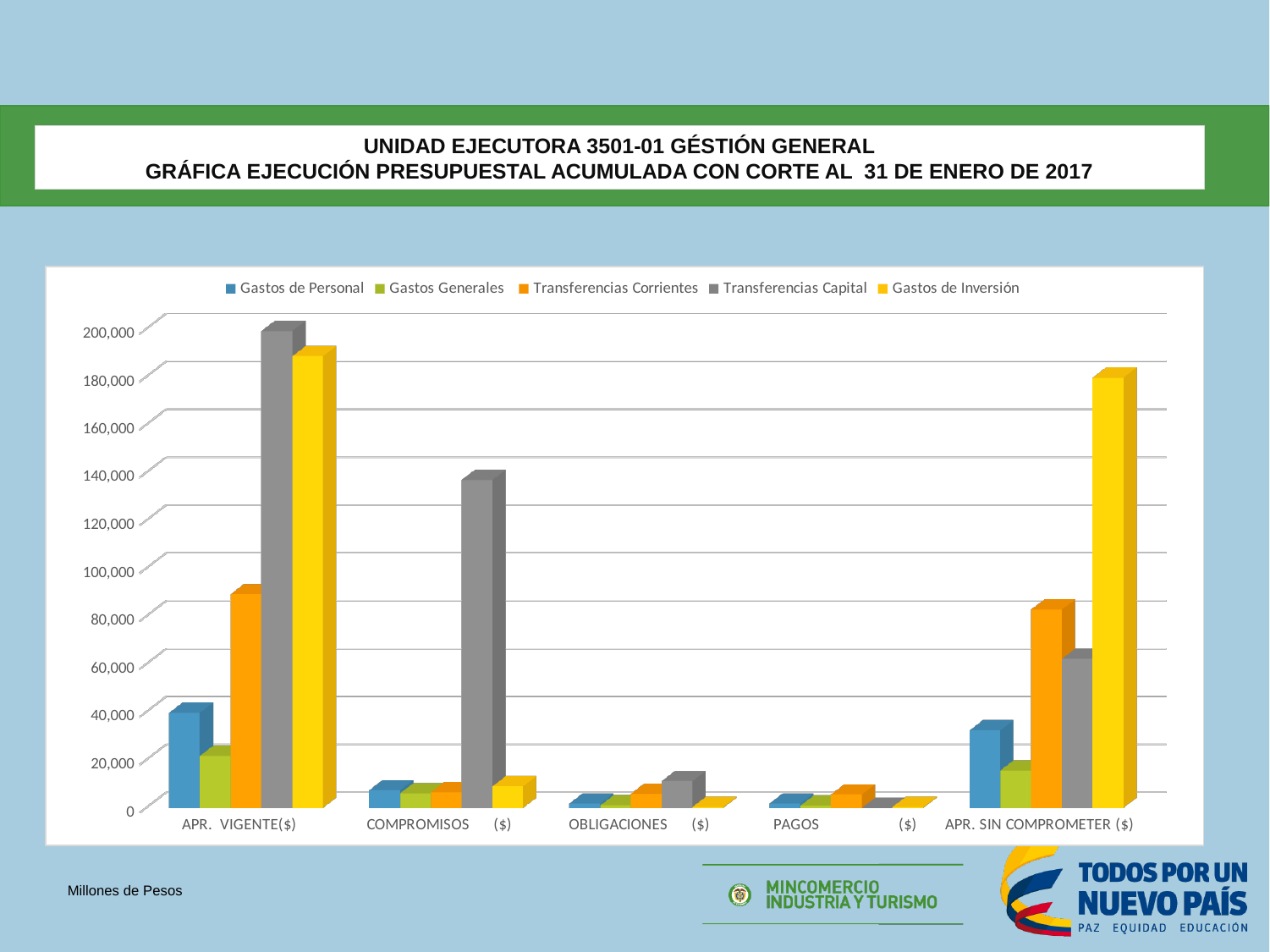
In the COMPROMISOS ($) category, which series has the highest value? Transferencias Capital Is the value for Transferencias Capital in COMPROMISOS ($) greater or less than 120,000? greater In the APR. VIGENTE($) category, which series has the lowest value? Gastos Generales How many series does the legend list? 5 In the APR. SIN COMPROMETER ($) category, which is larger: Transferencias Corrientes or Transferencias Capital? Transferencias Corrientes Is the value for Gastos de Personal in APR. VIGENTE($) greater or less than 60,000? less Is the value for Gastos de Inversión in APR. SIN COMPROMETER ($) greater or less than 160,000? greater What kind of chart is shown on the slide? bar chart What unit is stated below the chart for the values? Millones de Pesos In the APR. SIN COMPROMETER ($) category, which series has the highest value? Gastos de Inversión In the APR. VIGENTE($) category, which series has the highest value? Transferencias Capital How many categories are shown along the x axis? 5